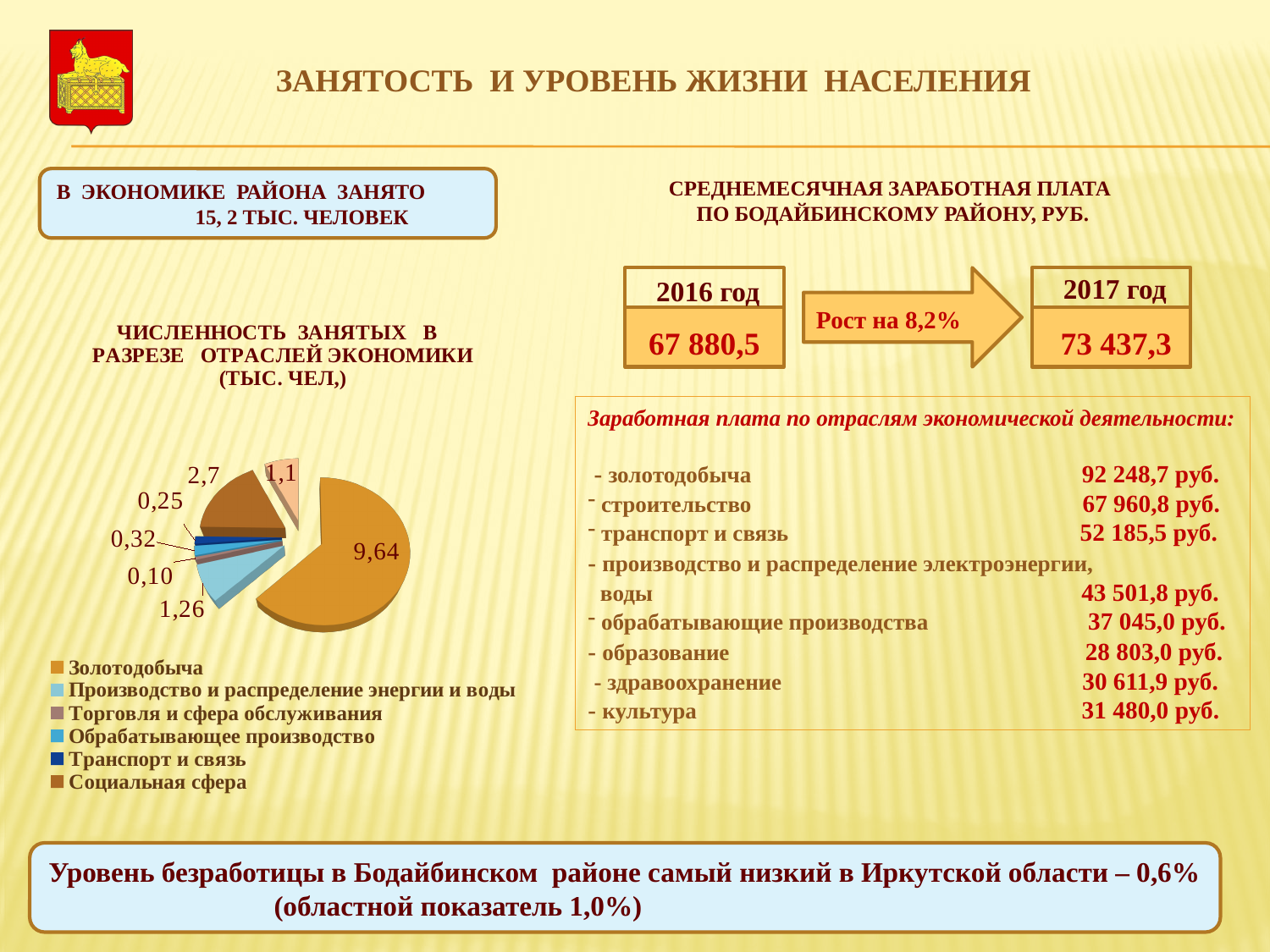
What is the value for Социальная сфера in the pie chart? 2,7 What is the difference between the values for Золотодобыча and Социальная сфера? 6,94 Which category has the largest slice in the pie chart? Золотодобыча What is the value for Транспорт и связь in the pie chart? 0,25 Which legend category has the smallest slice in the pie chart? Торговля и сфера обслуживания What is the value for Золотодобыча in the pie chart? 9,64 What kind of chart is shown on the slide? pie chart How many slices does the pie chart have? 7 What unit is given in the pie chart title? тыс. чел. What is the value for Производство и распределение энергии и воды in the pie chart? 1,26 How many categories does the pie chart legend list? 6 Which is larger: Обрабатывающее производство or Транспорт и связь? Обрабатывающее производство